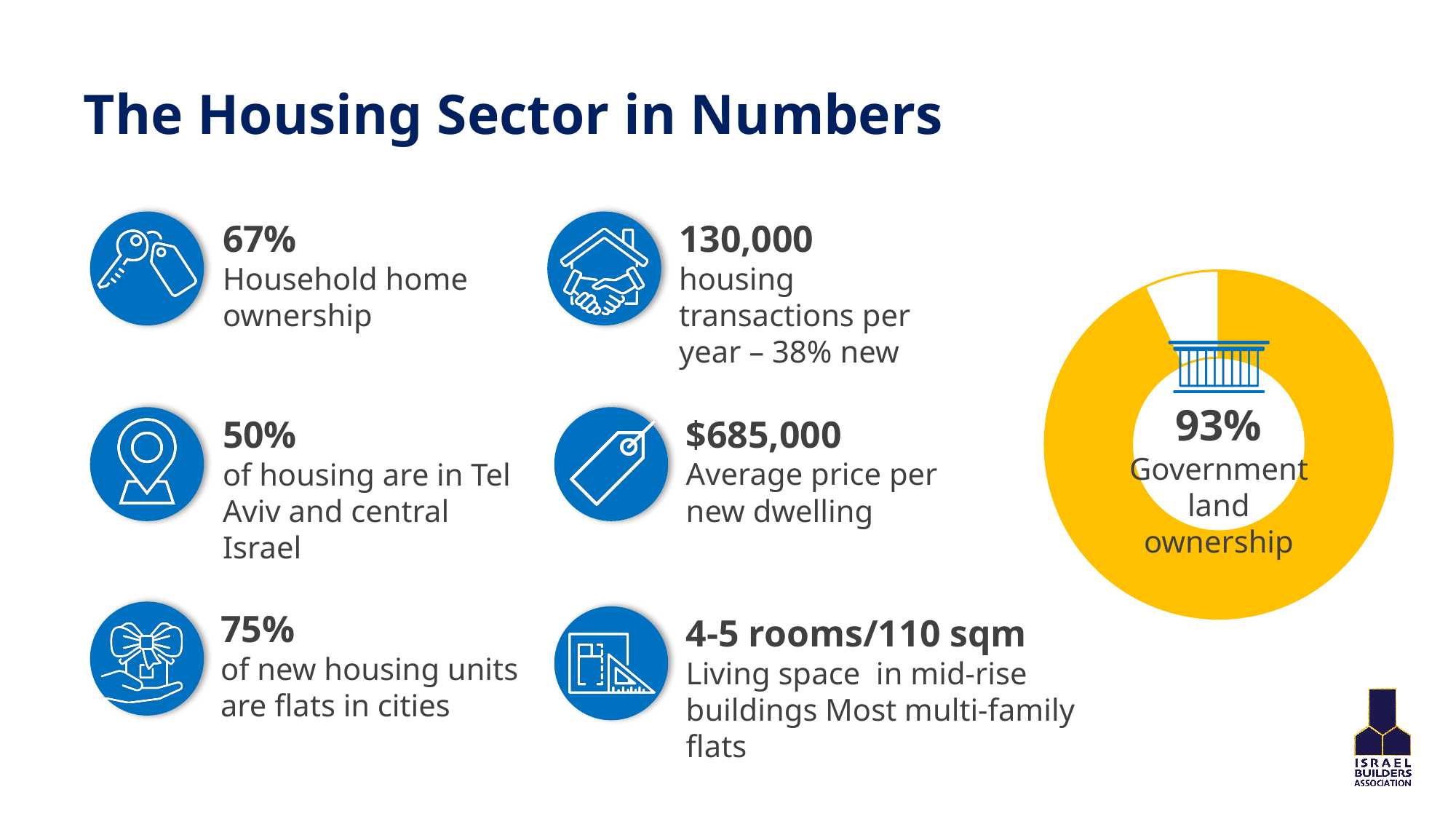
How many slices does the donut chart on the right have? 2 In the donut chart on the right, which slice is larger, the yellow one or the white one? the yellow one What does the donut chart on the right represent? Government land ownership What percentage does the donut chart on the right give for Government land ownership? 93% What colour is the large slice of the donut chart on the right? yellow Is the Government land ownership value shown in the donut chart greater or less than 90%? greater What share of the donut chart on the right is taken by the yellow slice? 93% What kind of chart is shown on the right side of the slide? pie chart (donut)